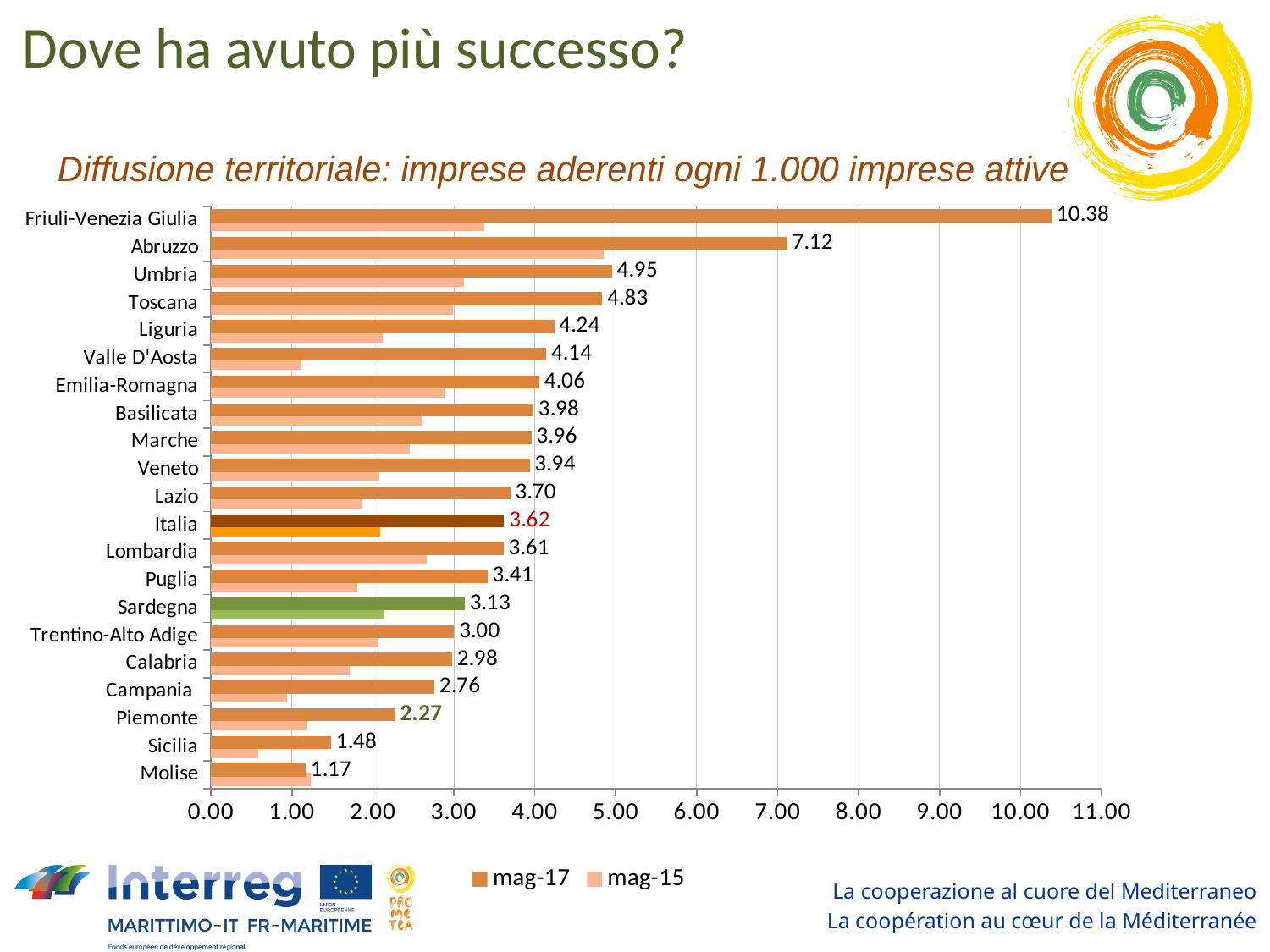
Which has the larger mag-17 value, Liguria or Lazio? Liguria What is the mag-17 value for Sardegna? 3.13 How many regions (categories) are shown on the chart? 21 Which region has the highest mag-17 value? Friuli-Venezia Giulia Is the mag-15 value for Abruzzo greater or less than 4.00? greater How many series does the legend list? 2 What type of chart is shown on the slide? Bar chart Is the mag-15 value for Valle D'Aosta greater or less than 2.00? less What is the difference between the mag-17 values of Friuli-Venezia Giulia and Abruzzo? 3.26 What is the mag-17 value for Italia? 3.62 Which region has the lowest mag-17 value? Molise What is the mag-17 value for Friuli-Venezia Giulia? 10.38